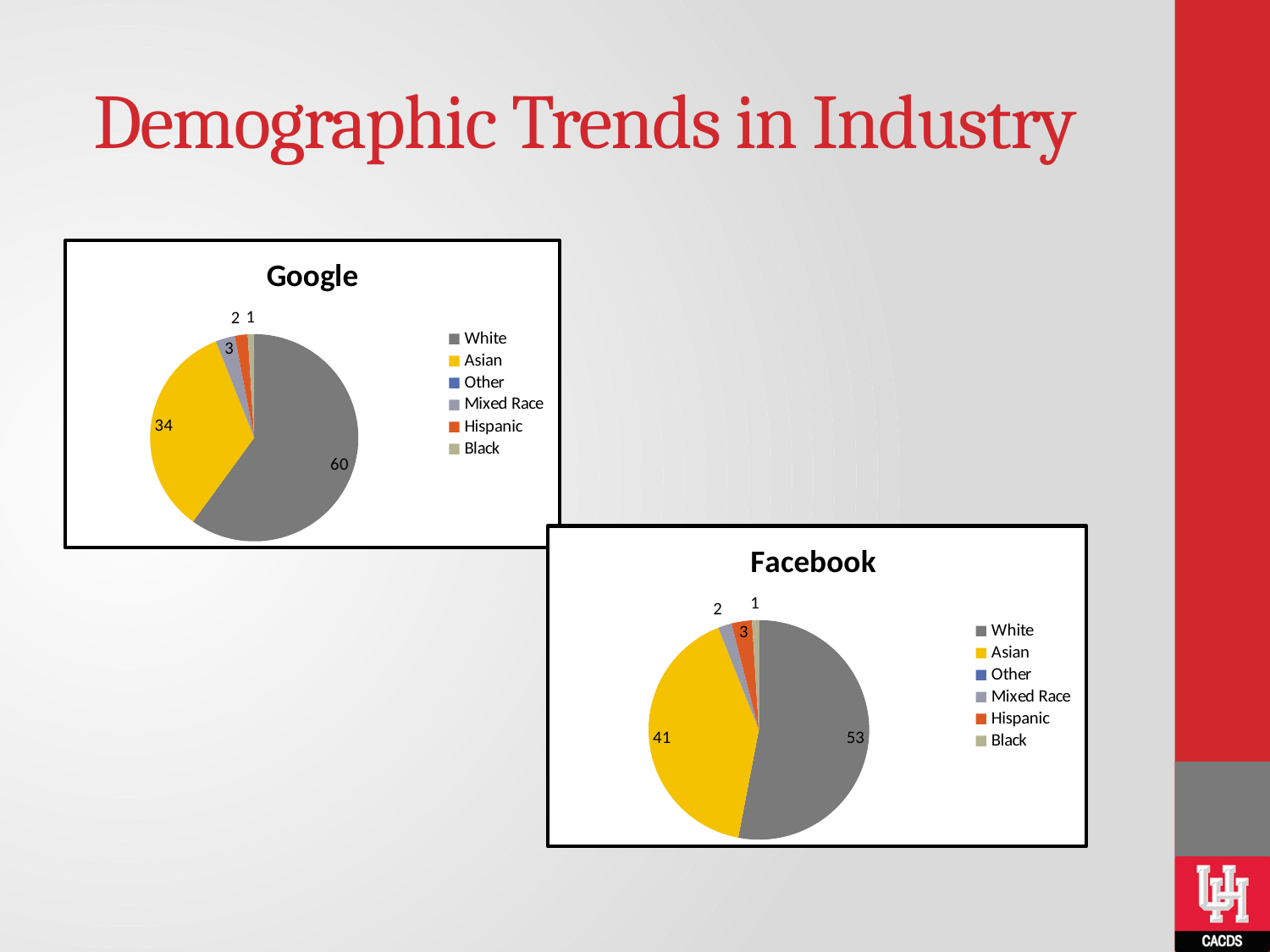
In the Google chart, what is the difference between the White and Asian values? 26 In the Google chart, which category has the largest slice? White In the Google chart, what is the value for Asian? 34 In the Facebook chart, what is the value for White? 53 Which is larger: the Asian value in the Google chart or the Asian value in the Facebook chart? Facebook In the Facebook chart, what is the value for Asian? 41 In the Facebook chart, what is the difference between the White and Asian values? 12 In the Google chart, what is the value for White? 60 How many entries does the legend of the Google chart list? 6 What kind of chart is the Facebook chart? Pie chart In the Facebook chart, which category has the largest slice? White In the Facebook chart, what is the value for Hispanic? 3